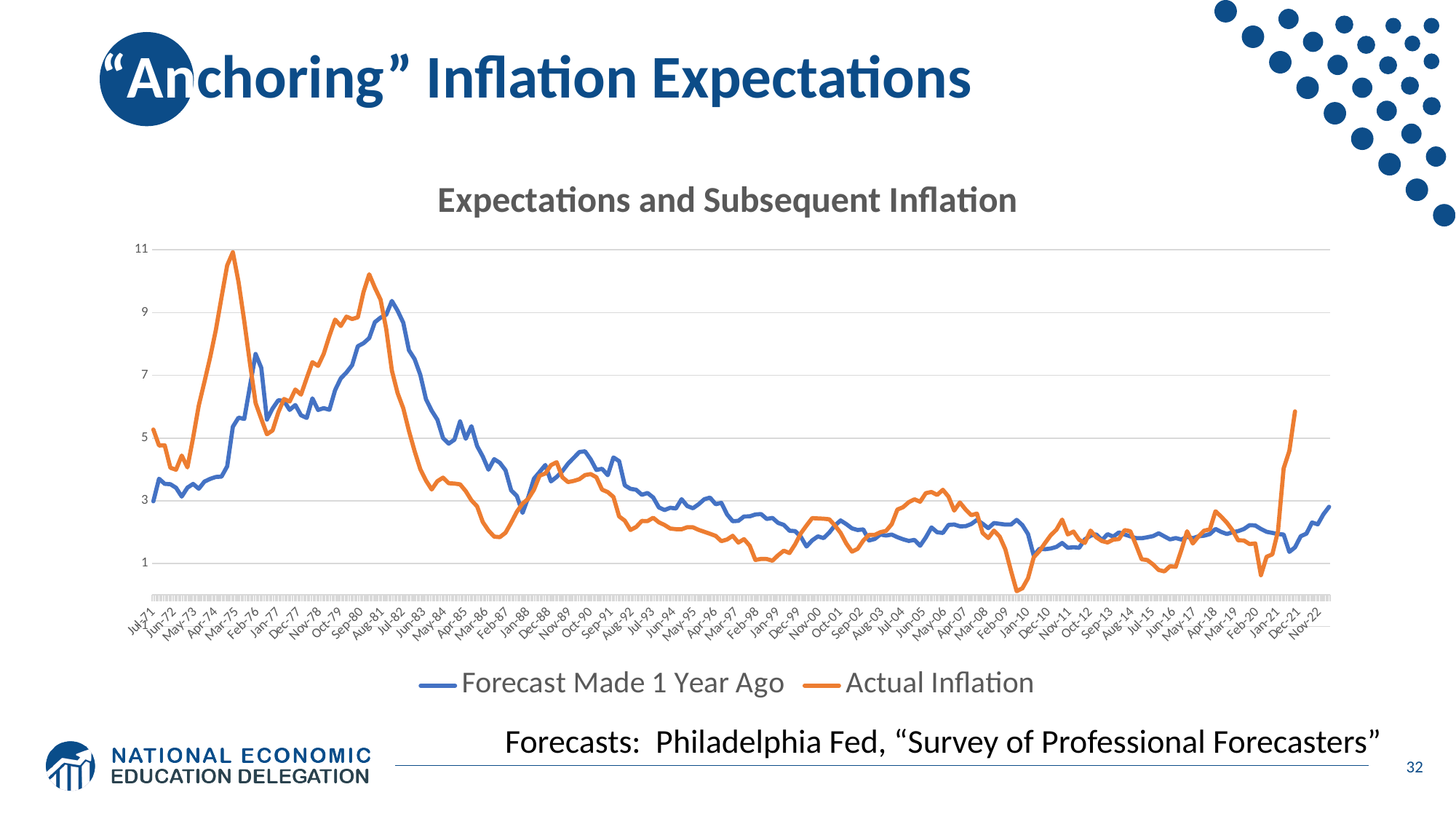
Around Mar-75, which series is higher: Forecast Made 1 Year Ago or Actual Inflation? Actual Inflation Does Actual Inflation rise or fall between Mar-75 and Feb-76? fall Is the value of Actual Inflation at Dec-21 greater or less than 5? greater Is the peak value of Forecast Made 1 Year Ago around Jul-82 greater or less than 7? greater Around Jul-82, which series is higher: Forecast Made 1 Year Ago or Actual Inflation? Forecast Made 1 Year Ago Which series reaches the highest peak on the chart? Actual Inflation What is the title of the chart? Expectations and Subsequent Inflation Is the value of Actual Inflation around Jan-10 greater or less than 1? less How many series does the chart's legend list? 2 Which series is drawn in orange? Actual Inflation What kind of chart is shown on the slide? line chart